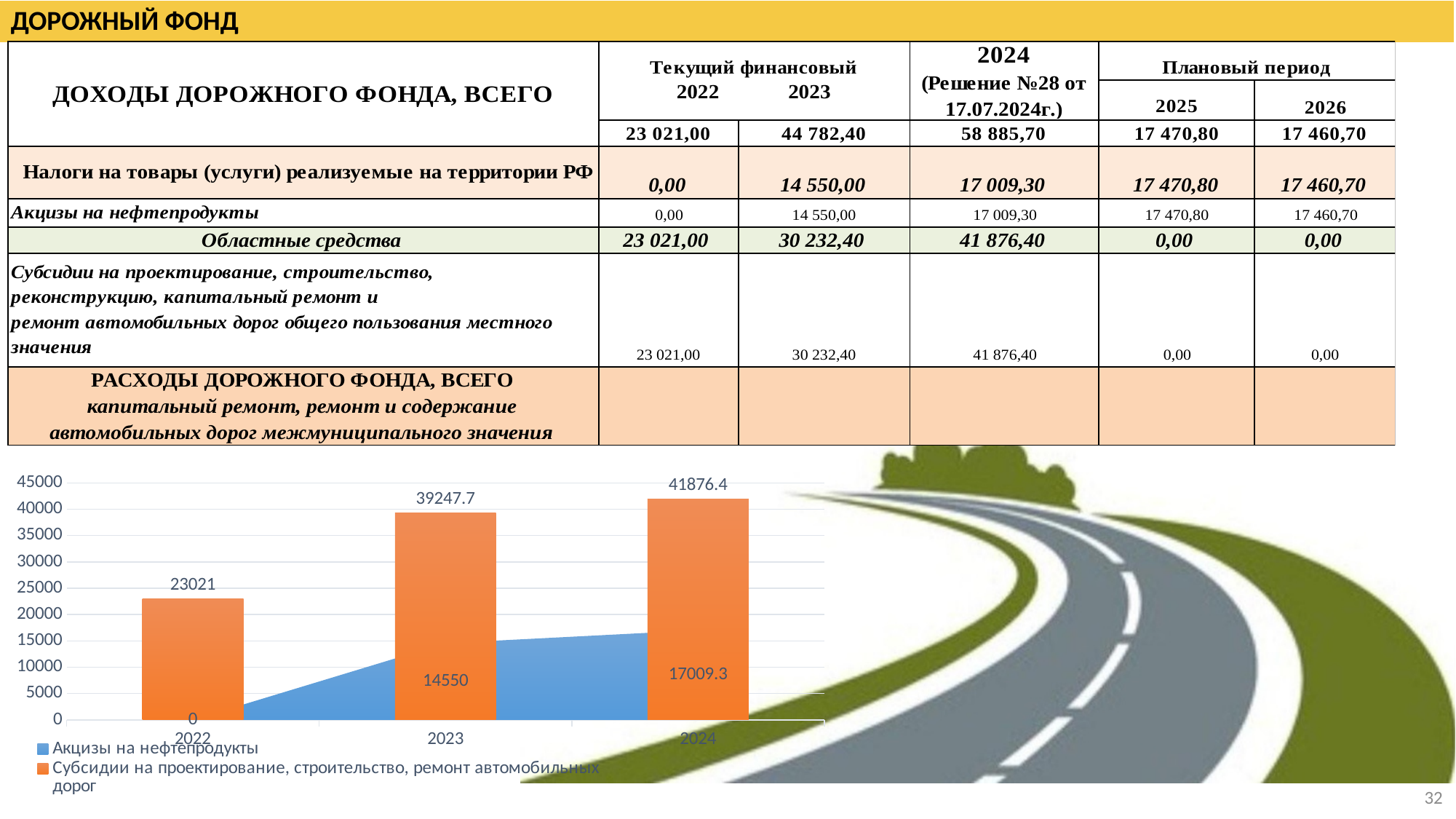
In the chart, what is the difference between the subsidies values for 2024 and 2023? 2628.7 In the chart, which year has the highest subsidies (Субсидии) value? 2024 How many years are shown on the x axis of the chart? 3 In the chart, what is the value of the subsidies (Субсидии) bar for 2022? 23021 How many series does the chart legend list? 2 In the chart, which is larger in 2024: the subsidies value or the Акцизы на нефтепродукты value? Subsidies (41876.4) In the chart, what is the value of the subsidies (Субсидии) bar for 2024? 41876.4 In the chart, what is the value labelled for Акцизы на нефтепродукты in 2024? 17009.3 In the chart, what is the value of the subsidies (Субсидии) bar for 2023? 39247.7 Do the subsidies (Субсидии) values rise or fall from 2022 to 2024 in the chart? Rise In the chart, what is the value labelled for Акцизы на нефтепродукты in 2023? 14550 In the chart, which year has the lowest value for Акцизы на нефтепродукты? 2022